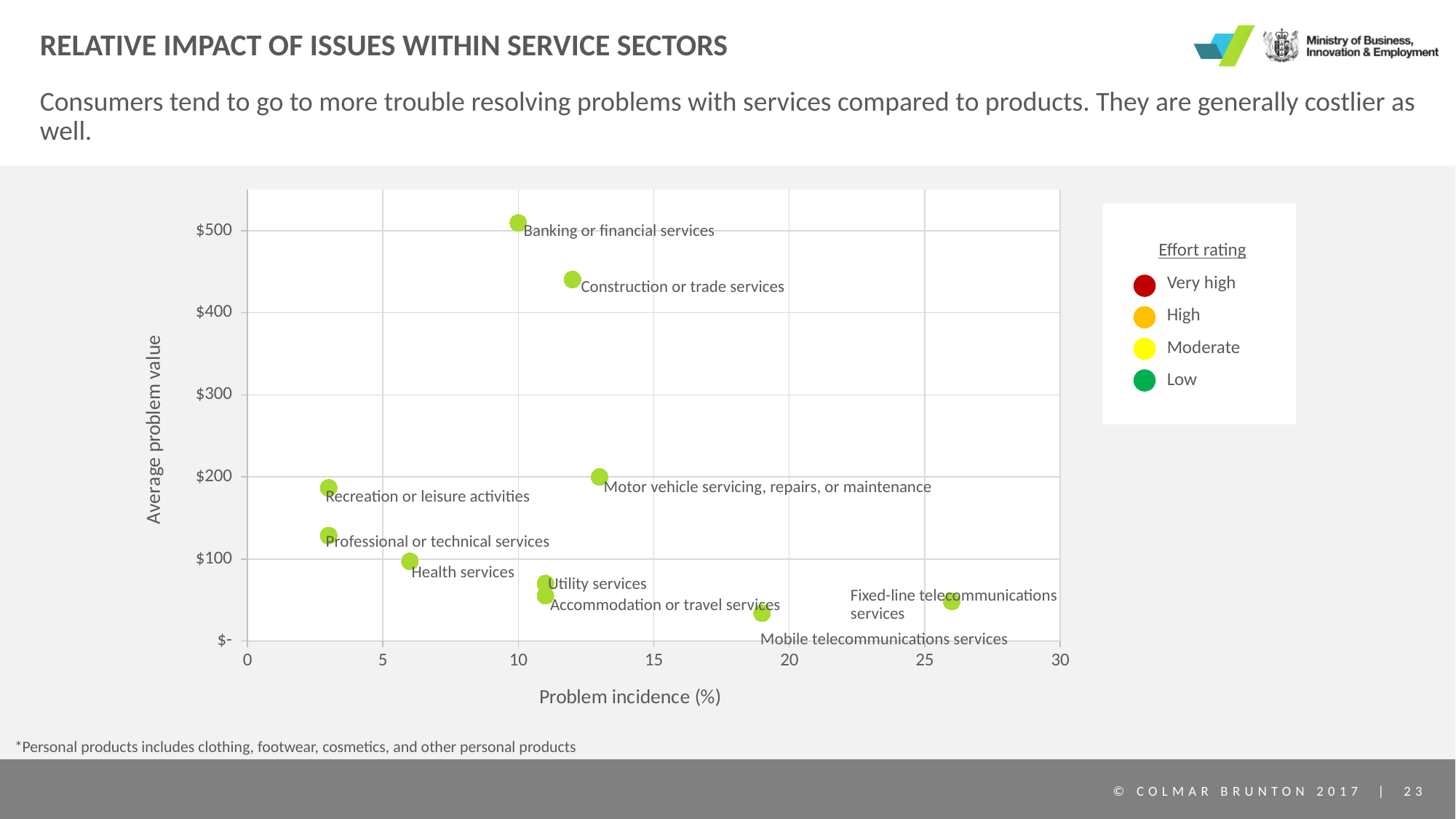
What kind of chart is shown on the slide? Scatter chart Is the problem incidence for Fixed-line telecommunications services greater or less than 25%? greater Which service sector has the highest problem incidence? Fixed-line telecommunications services Is the average problem value for Recreation or leisure activities greater or less than $200? less Which service sector has the lowest problem incidence? Recreation or leisure activities and Professional or technical services How many effort rating categories does the legend list? 4 How many service sectors are plotted on the chart? 10 Which has a higher average problem value, Construction or trade services or Motor vehicle servicing, repairs, or maintenance? Construction or trade services Is the average problem value for Mobile telecommunications services greater or less than $100? less Which service sector has the highest average problem value? Banking or financial services What is the title of the x axis? Problem incidence (%)